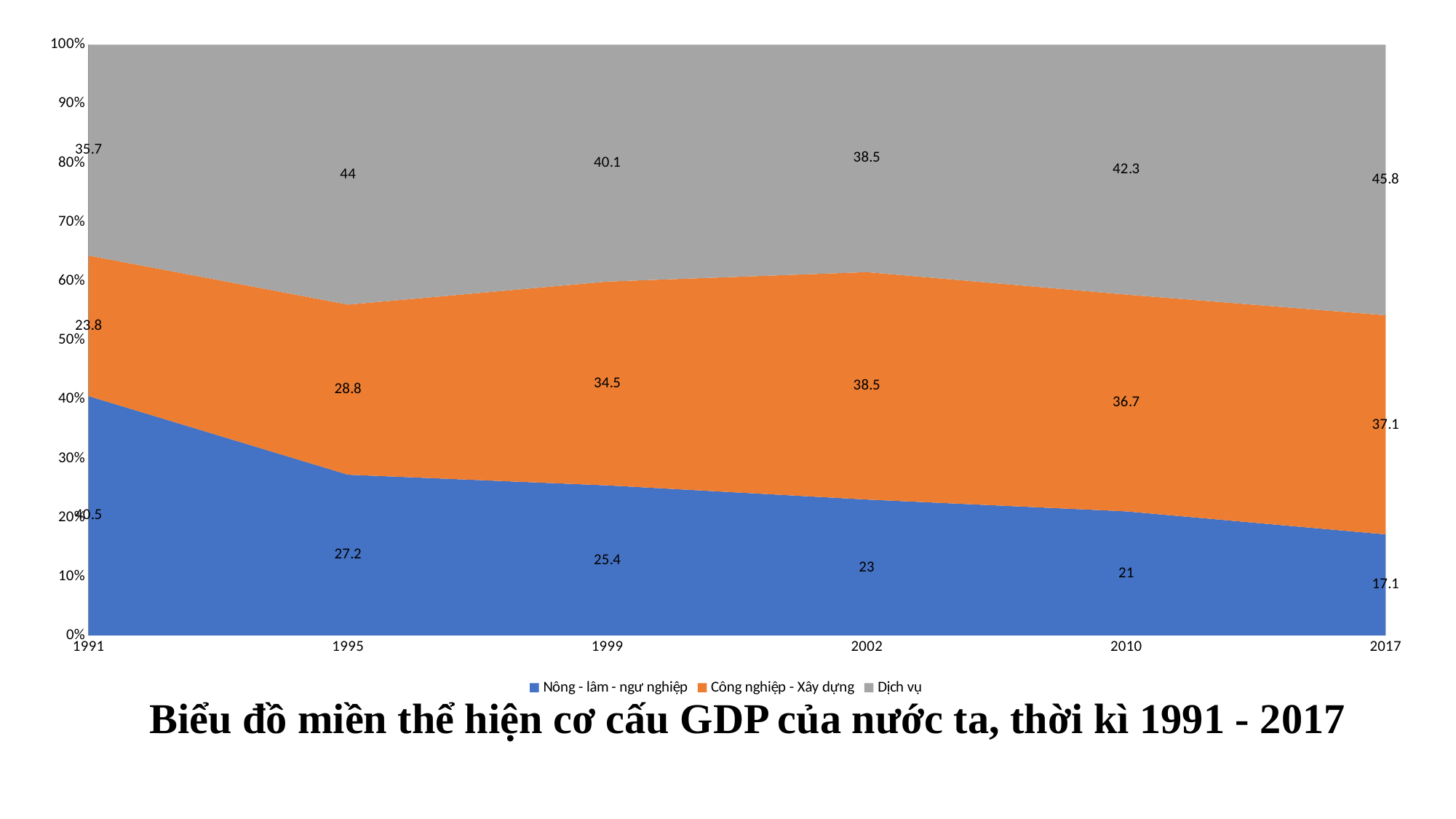
How many series does the legend list? 3 What is the value for Dịch vụ in 2017? 45.8 What kind of chart is shown on the slide? stacked area chart In which year is the value for Dịch vụ highest? 2017 What is the difference between the Dịch vụ values in 2017 and 2010? 3.5 In which year is the value for Nông - lâm - ngư nghiệp lowest? 2017 Which is larger in 2010: Công nghiệp - Xây dựng or Dịch vụ? Dịch vụ How many years are shown on the x axis? 6 What is the value for Nông - lâm - ngư nghiệp in 1995? 27.2 Does the value for Nông - lâm - ngư nghiệp rise or fall from 1995 to 2017? fall What is the value for Dịch vụ in 1999? 40.1 What is the value for Công nghiệp - Xây dựng in 2002? 38.5